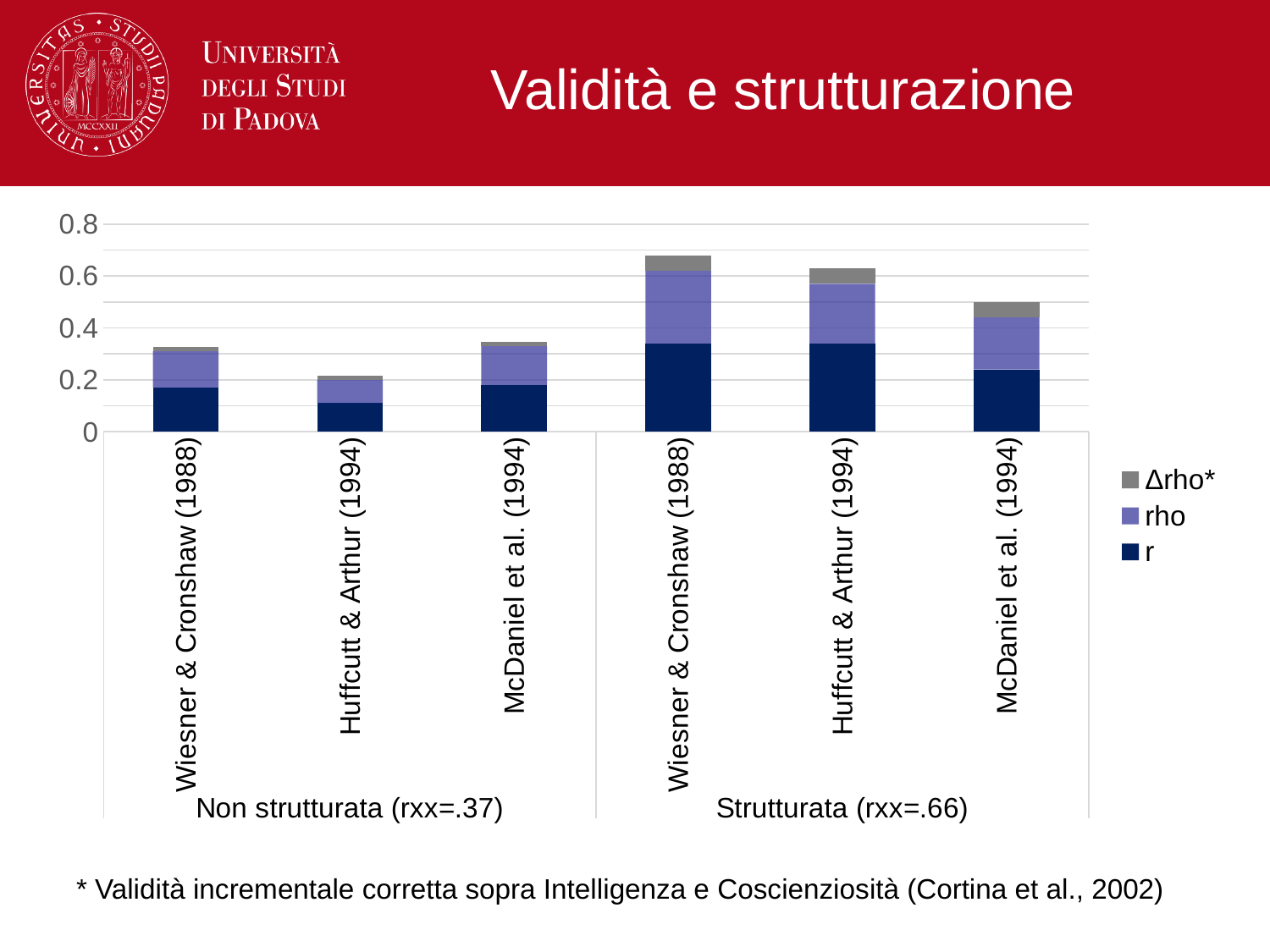
How many bars are plotted in the chart? 6 What are the two group labels shown below the category axis? Non strutturata (rxx=.37) and Strutturata (rxx=.66) Which series is shown in grey in the legend? Δrho* How many series does the legend list? 3 Is the r value for Huffcutt & Arthur (1994) in the Non strutturata group greater or less than 0.2? less Is the total value for Huffcutt & Arthur (1994) in the Non strutturata group greater or less than 0.4? less Is the total value for McDaniel et al. (1994) in the Strutturata group greater or less than 0.6? less Which bar has the highest total value? Wiesner & Cronshaw (1988), Strutturata Which bar has the lowest total value? Huffcutt & Arthur (1994), Non strutturata Which is larger: the total for Huffcutt & Arthur (1994) in the Strutturata group or in the Non strutturata group? Strutturata What kind of chart is shown on the slide? Stacked bar chart